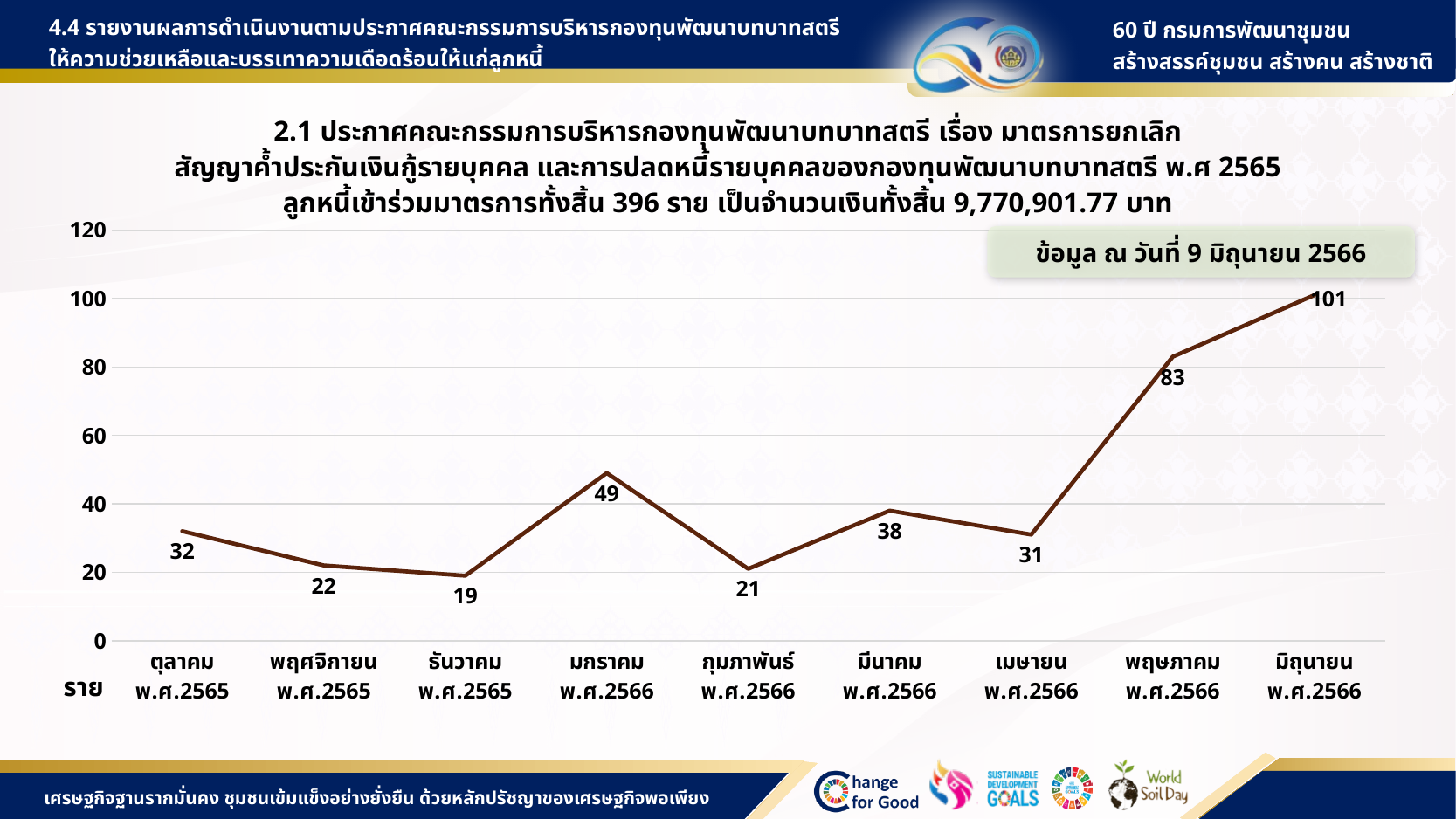
What is the difference between the values for มิถุนายน พ.ศ.2566 and พฤษภาคม พ.ศ.2566? 18 How many months are plotted on the chart? 9 Do the values rise or fall from เมษายน พ.ศ.2566 to มิถุนายน พ.ศ.2566? rise Is the value for พฤษภาคม พ.ศ.2566 greater or less than 80? greater Which month has the highest value? มิถุนายน พ.ศ.2566 Which is larger, the value for มีนาคม พ.ศ.2566 or the value for เมษายน พ.ศ.2566? มีนาคม พ.ศ.2566 What kind of chart is shown on the slide? line chart What is the value for พฤษภาคม พ.ศ.2566? 83 What is the date of the data shown in the box on the chart? 9 มิถุนายน 2566 What is the value for มกราคม พ.ศ.2566? 49 What is the value for ตุลาคม พ.ศ.2565? 32 Which month has the lowest value? ธันวาคม พ.ศ.2565